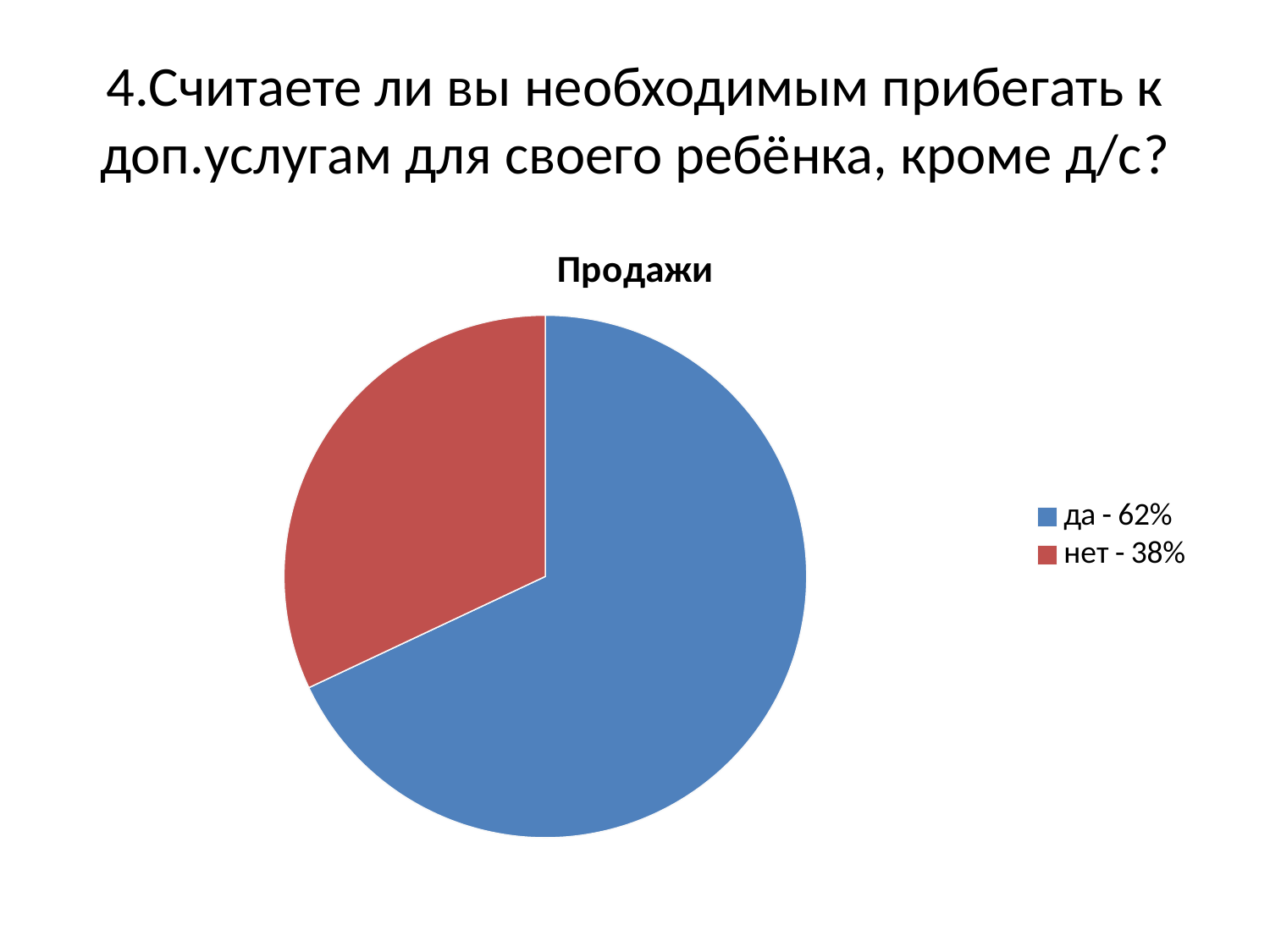
What kind of chart is shown on the slide? pie chart What is the title of the chart? Продажи What share of the pie does the "нет" slice represent? 38% What colour is the "нет" slice? red How many slices does the pie chart have? 2 Which slice is the largest? да - 62% Which slice is the smallest? нет - 38% How many entries does the legend list? 2 What share of the pie does the "да" slice represent? 62% Is the share for "да" greater or less than 50%? greater What is the difference in percentage points between the "да" and "нет" slices? 24 Which is larger, the "да" slice or the "нет" slice? да